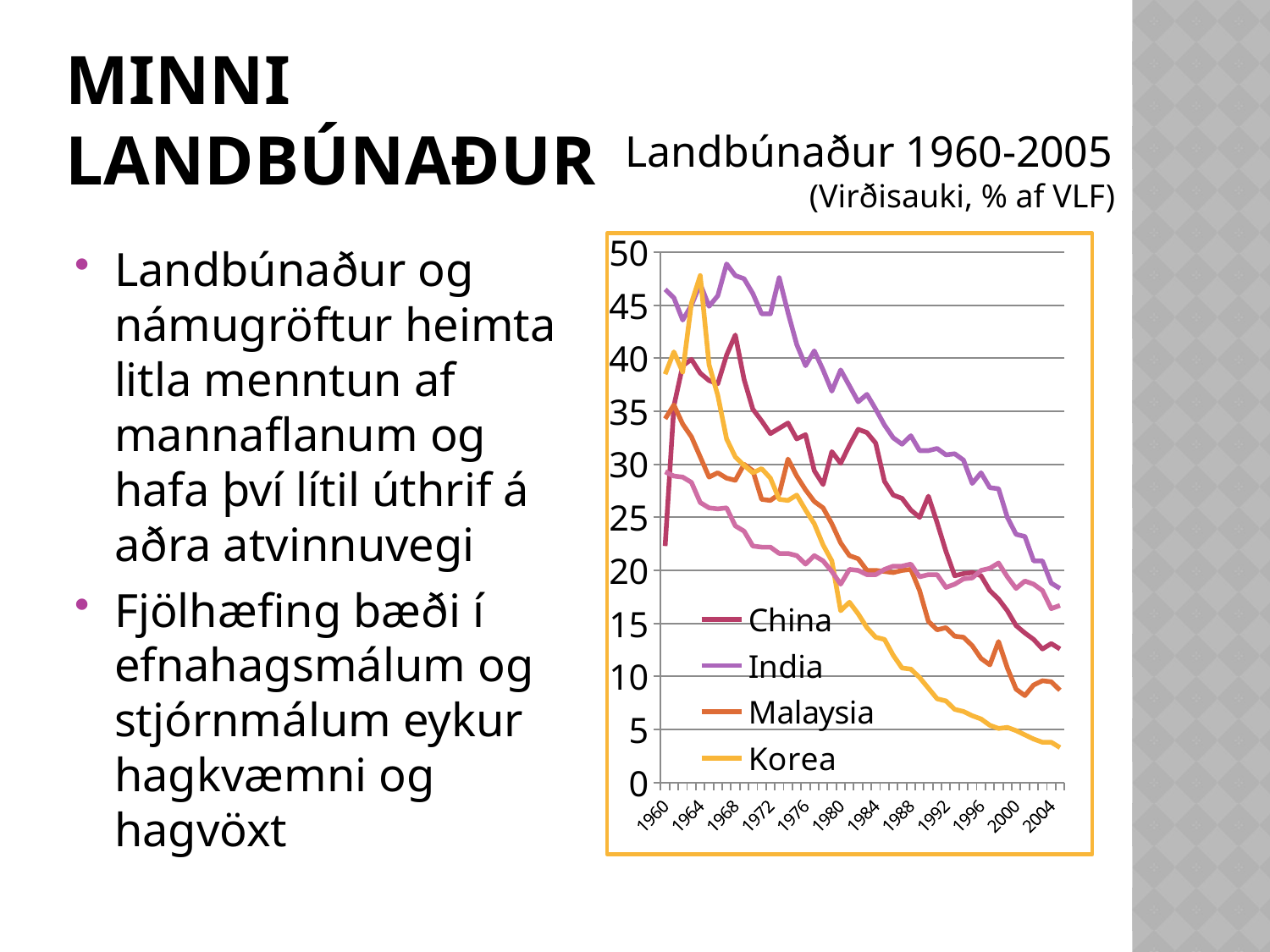
Is the value for Korea in 2004 greater or less than 5? less Which series has the highest value in 1960? India In 1990, which is larger, the value for Malaysia or the value for Korea? Malaysia Which countries are listed in the chart legend? China, India, Malaysia, Korea What is the title of the chart? Landbúnaður 1960-2005 Is the value for India in 1968 greater or less than 45? greater Which series has the lowest value in 2004? Korea Is the value for China in 2004 greater or less than 15? less How many series does the chart legend list? 4 In 1980, which is larger, the value for India or the value for China? India What kind of chart is shown on the slide? Line chart Does the value for Korea rise or fall from 1964 to 2004? Fall